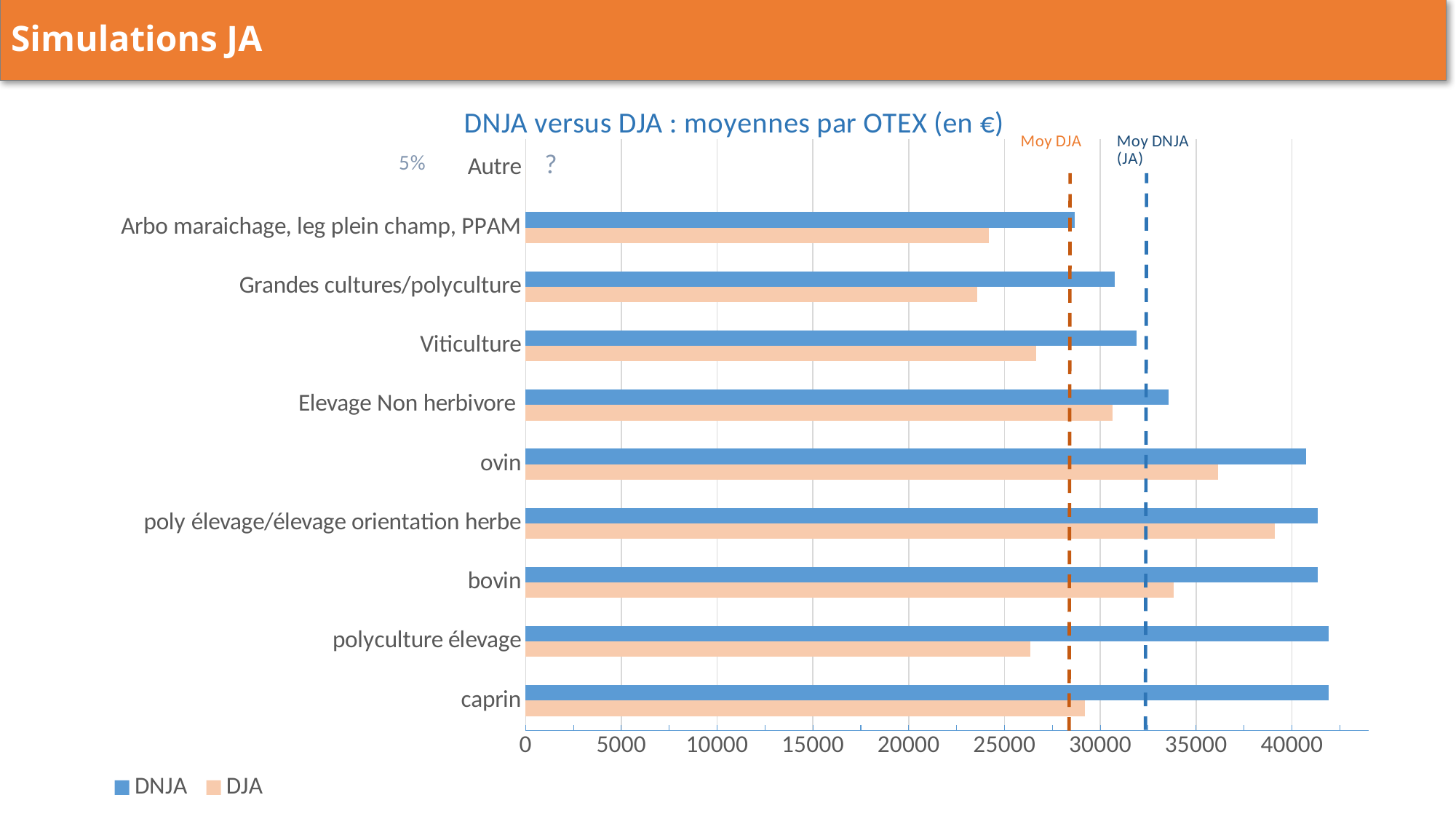
Which category has the highest DJA value? poly élevage/élevage orientation herbe Is the DJA value for ovin greater or less than 35000? greater What is the title of the chart? DNJA versus DJA : moyennes par OTEX (en €) Is the DJA value for Grandes cultures/polyculture greater or less than 25000? less Is the DNJA value for Viticulture greater or less than 30000? greater What kind of chart is shown on the slide? bar chart Which series is shown in blue in the legend? DNJA How many series does the legend list? 2 How many categories are labelled on the vertical axis of the chart? 10 For polyculture élevage, which is larger: the DNJA value or the DJA value? DNJA Which category with plotted bars has the lowest DNJA value? Arbo maraichage, leg plein champ, PPAM